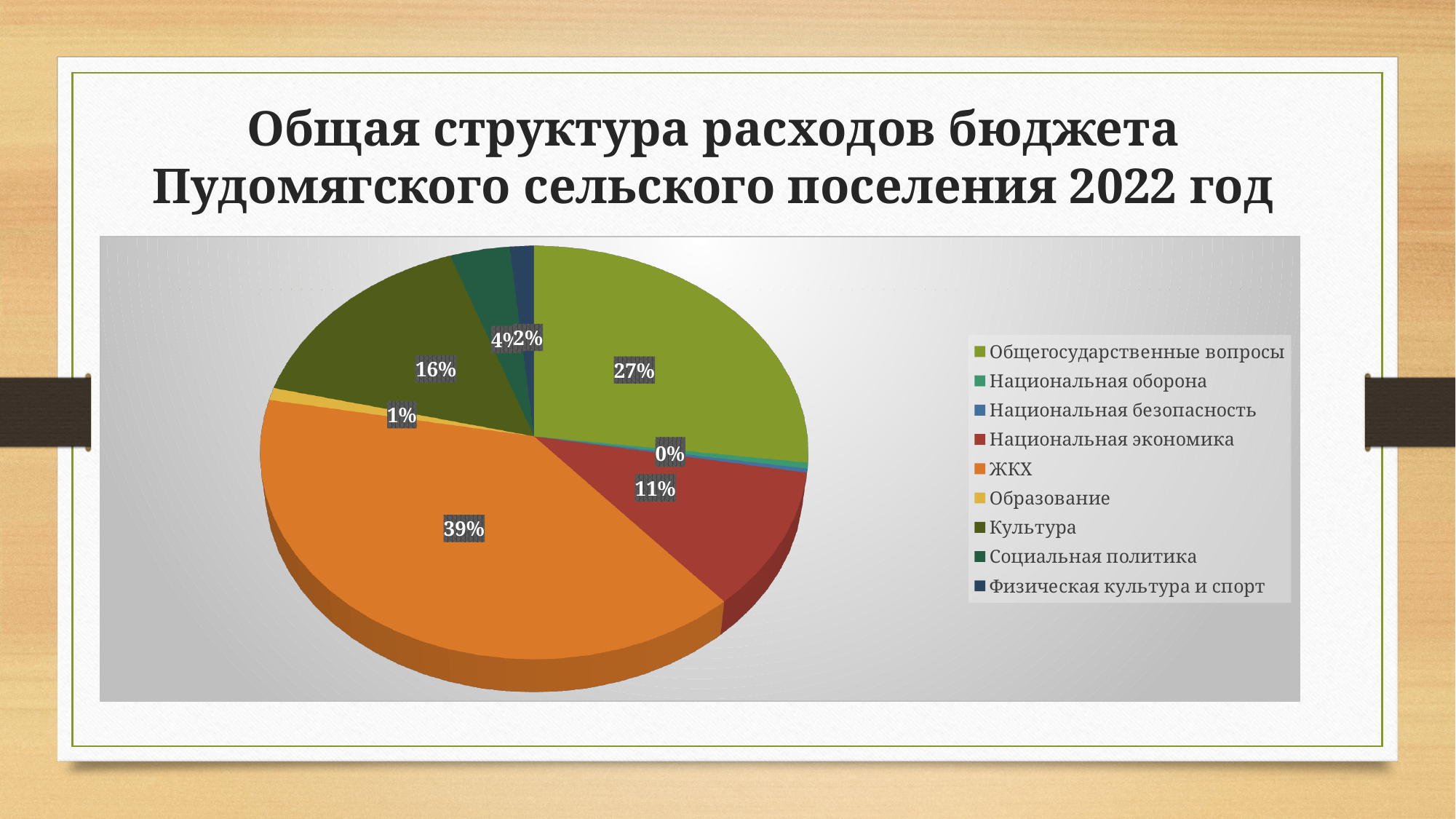
What share of the pie does Образование have? 1% What share of the pie does ЖКХ have? 39% What share of the pie does Культура have? 16% Which category has the largest share of the pie? ЖКХ What kind of chart is shown on the slide? pie chart What is the title of the slide containing the chart? Общая структура расходов бюджета Пудомягского сельского поселения 2022 год What share of the pie does Общегосударственные вопросы have? 27% Which is larger, the share for Культура or the share for Национальная экономика? Культура What share of the pie does Социальная политика have? 4% What share of the pie does Национальная экономика have? 11% How many categories does the legend list? 9 What is the difference between the share for ЖКХ and the share for Общегосударственные вопросы? 12%